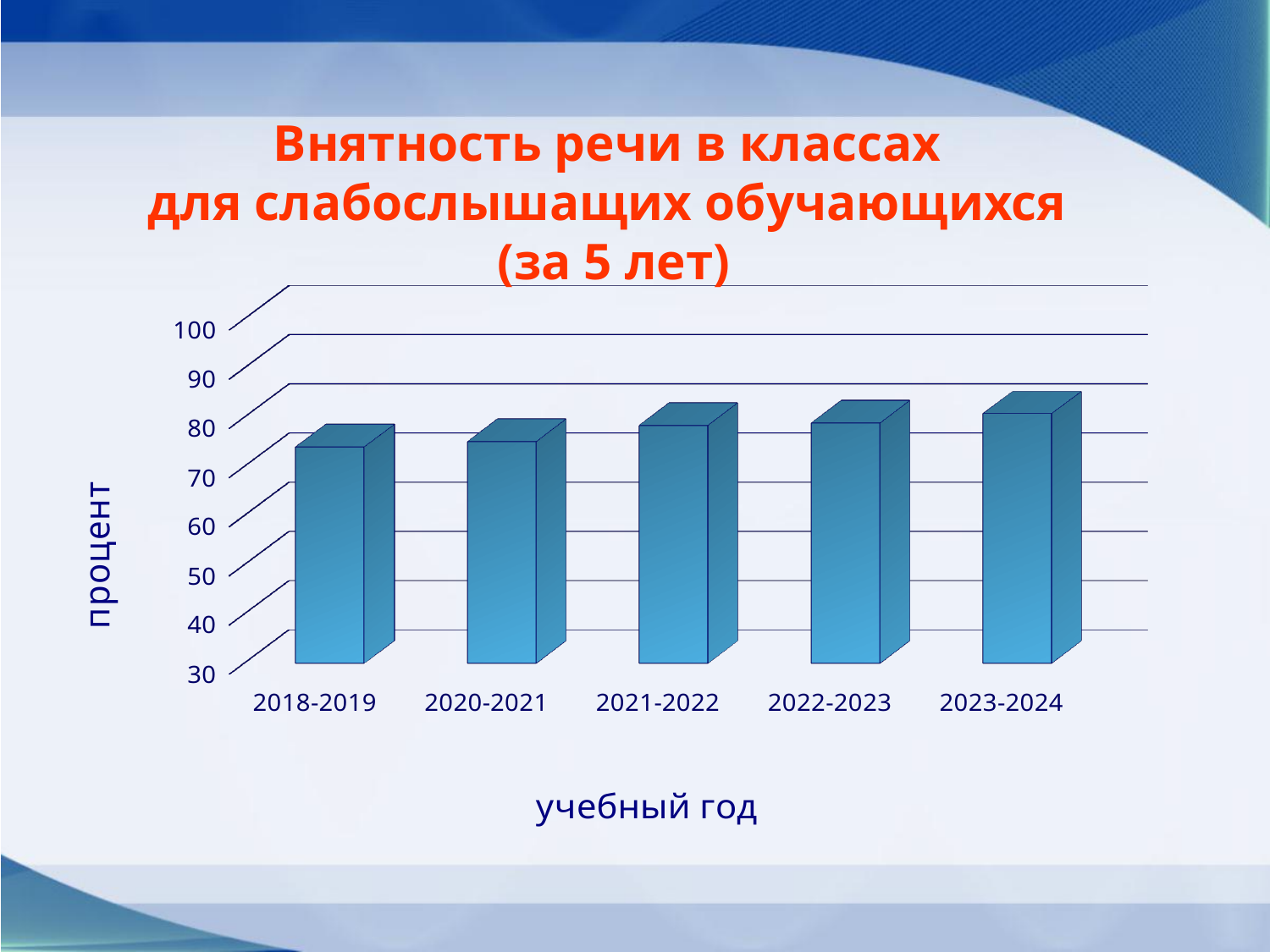
Is the value for 2018-2019 greater or less than 80? less Do the values rise or fall from 2018-2019 to 2023-2024? rise Which is larger, the value for 2020-2021 or the value for 2023-2024? 2023-2024 What is the label of the horizontal axis? учебный год How many academic years (categories) are plotted on the chart? 5 Is the value for 2018-2019 greater or less than 70? greater Is the value for 2020-2021 greater or less than 80? less What kind of chart is shown on the slide? bar chart What is the label of the vertical axis? процент Which academic year has the highest value on the chart? 2023-2024 Which is larger, the value for 2023-2024 or the value for 2018-2019? 2023-2024 Which academic year has the lowest value on the chart? 2018-2019